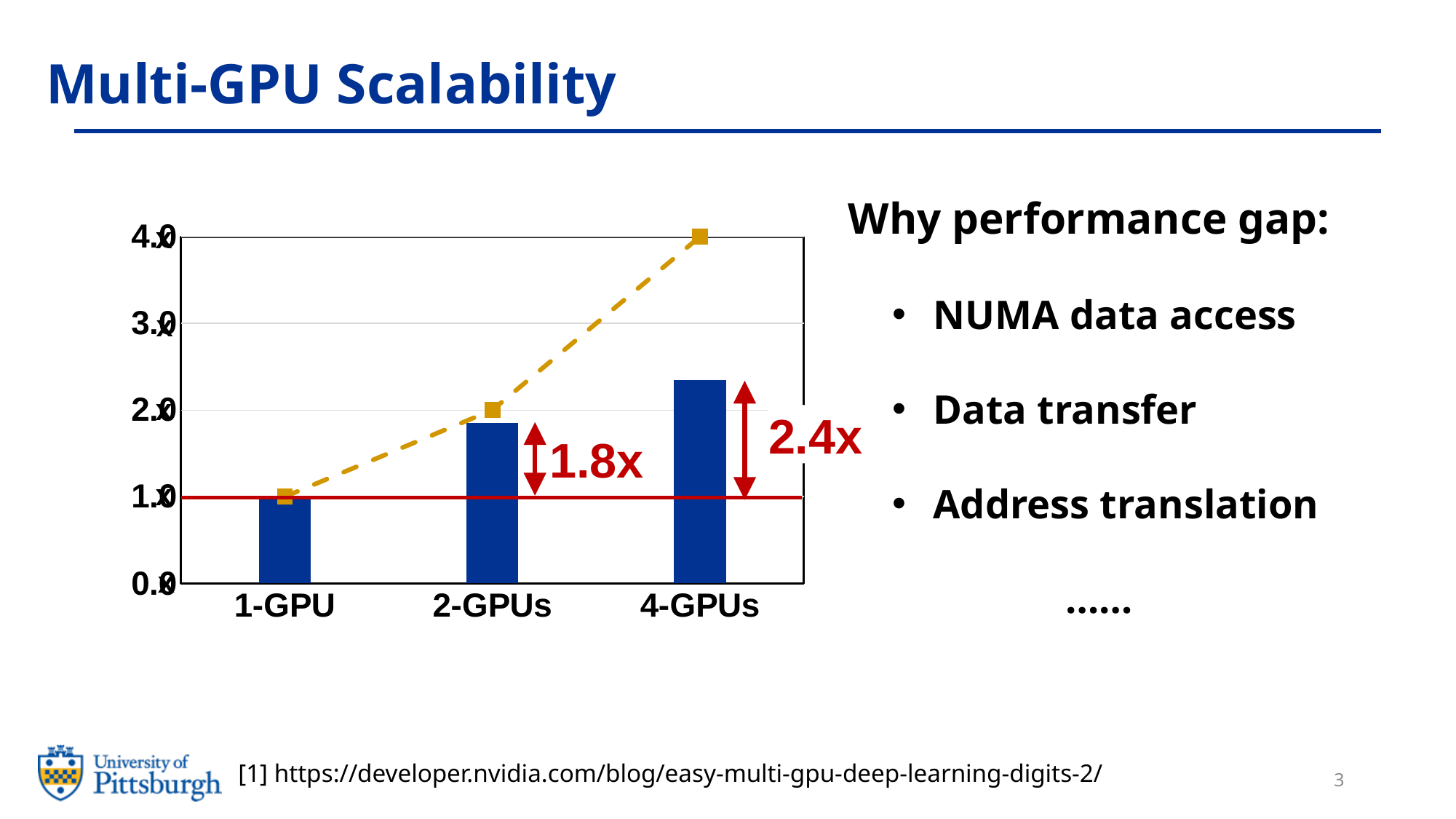
What kind of chart is shown on the slide? bar and line chart What value does the dashed line reach at 4-GPUs? 4.0 Which category has the tallest bar? 4-GPUs What speedup is annotated next to the 4-GPUs bar? 2.4x How many categories are shown on the x axis of the chart? 3 What colour are the bars in the chart? blue Which category has the shortest bar? 1-GPU Is the bar for 4-GPUs greater or less than 2.0? greater What speedup is annotated next to the 2-GPUs bar? 1.8x Do the bar values rise or fall from 1-GPU to 4-GPUs? rise Is the bar for 4-GPUs greater or less than 3.0? less Is the bar for 2-GPUs greater or less than 2.0? less